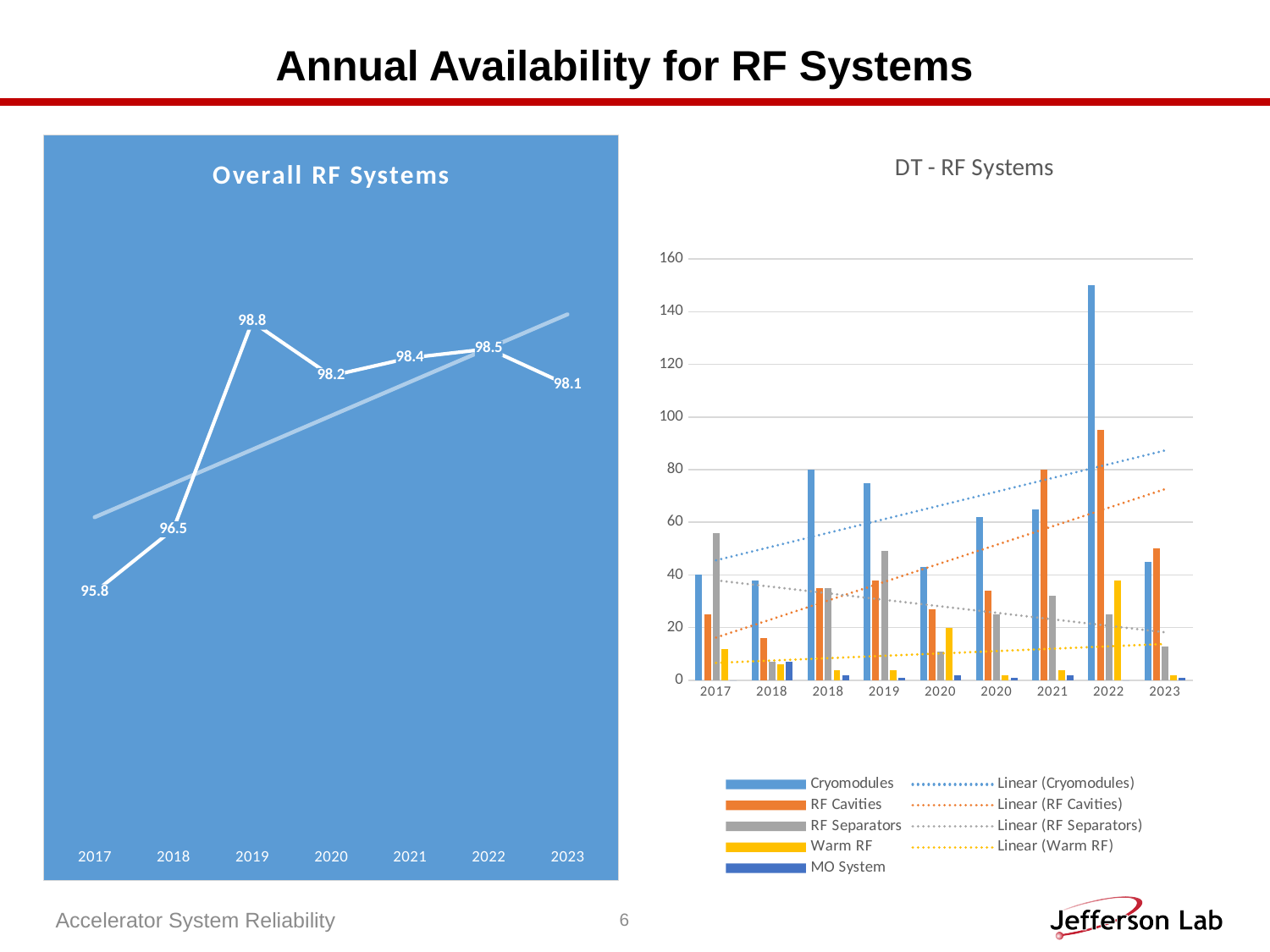
In the Overall RF Systems chart, what is the value for 2019? 98.8 In the Overall RF Systems chart, what is the value for 2017? 95.8 In the Overall RF Systems chart, what is the difference between the 2019 value and the 2017 value? 3.0 In the Overall RF Systems chart, do the values rise or fall from 2017 to 2019? Rise In the DT - RF Systems chart, is the Cryomodules value for 2022 greater or less than 140? greater In the Overall RF Systems chart, which year has the larger value, 2021 or 2022? 2022 In the Overall RF Systems chart, which year has the lowest value? 2017 In the DT - RF Systems chart, which series has the tallest bar in 2022? Cryomodules In the Overall RF Systems chart, which year has the highest value? 2019 How many years are plotted in the Overall RF Systems chart? 7 In the DT - RF Systems chart, is the RF Cavities value for 2022 greater or less than 100? less What kind of chart is the Overall RF Systems chart? Line chart